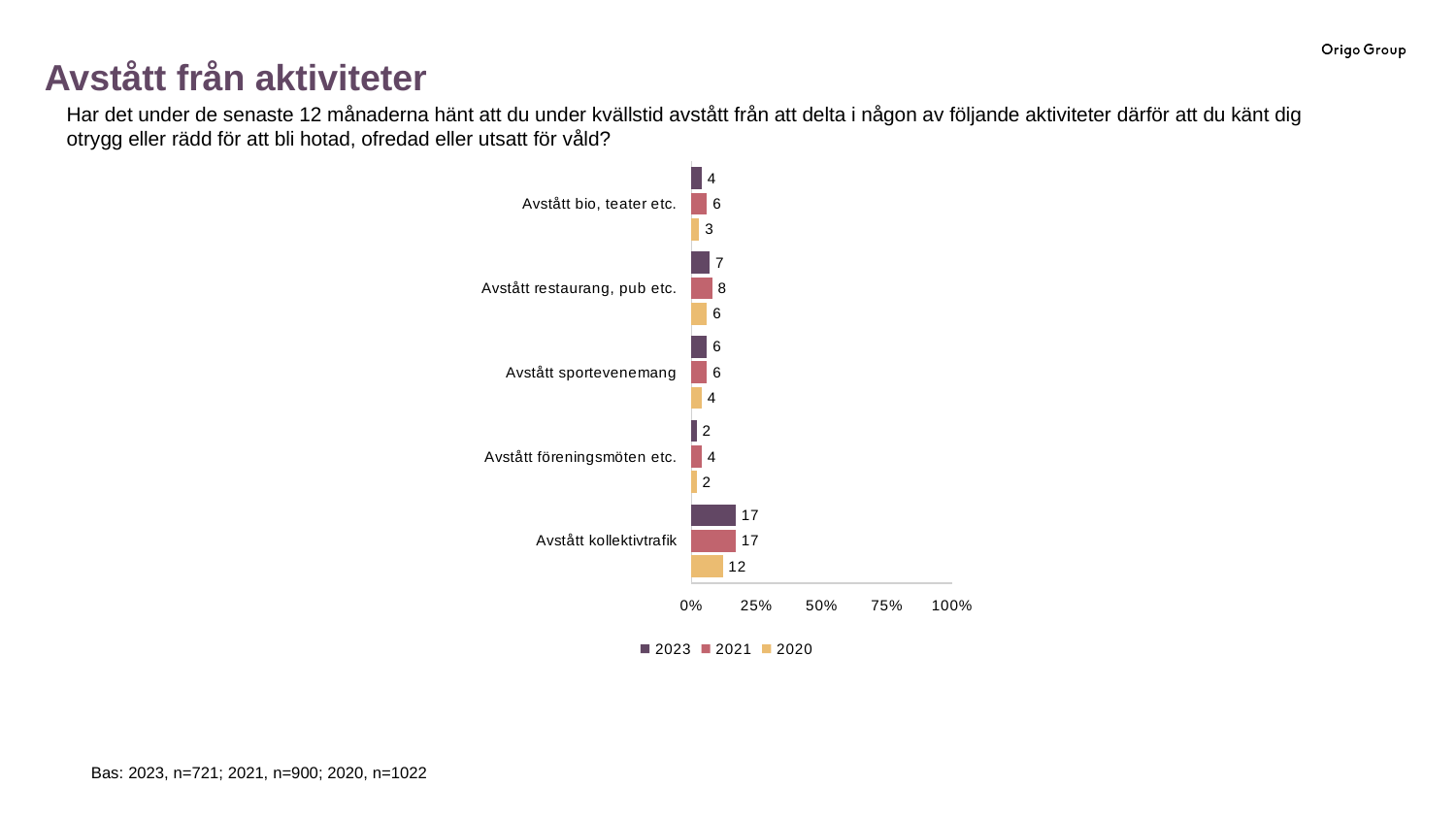
Which category has the highest value in the 2020 series? Avstått kollektivtrafik What is the value for 'Avstått restaurang, pub etc.' in the 2021 series? 8 How many categories are shown on the chart? 5 What kind of chart is shown on the slide? Bar chart How many series does the legend list? 3 Which category has the lowest value in the 2023 series? Avstått föreningsmöten etc. What is the value for 'Avstått bio, teater etc.' in the 2020 series? 3 Which is larger for 'Avstått sportevenemang': the 2023 value or the 2020 value? 2023 Is the 2023 value for 'Avstått kollektivtrafik' greater or less than 25%? less What is the value for 'Avstått kollektivtrafik' in the 2023 series? 17 What is the difference between the 2021 and 2020 values for 'Avstått kollektivtrafik'? 5 What is the title of the slide? Avstått från aktiviteter